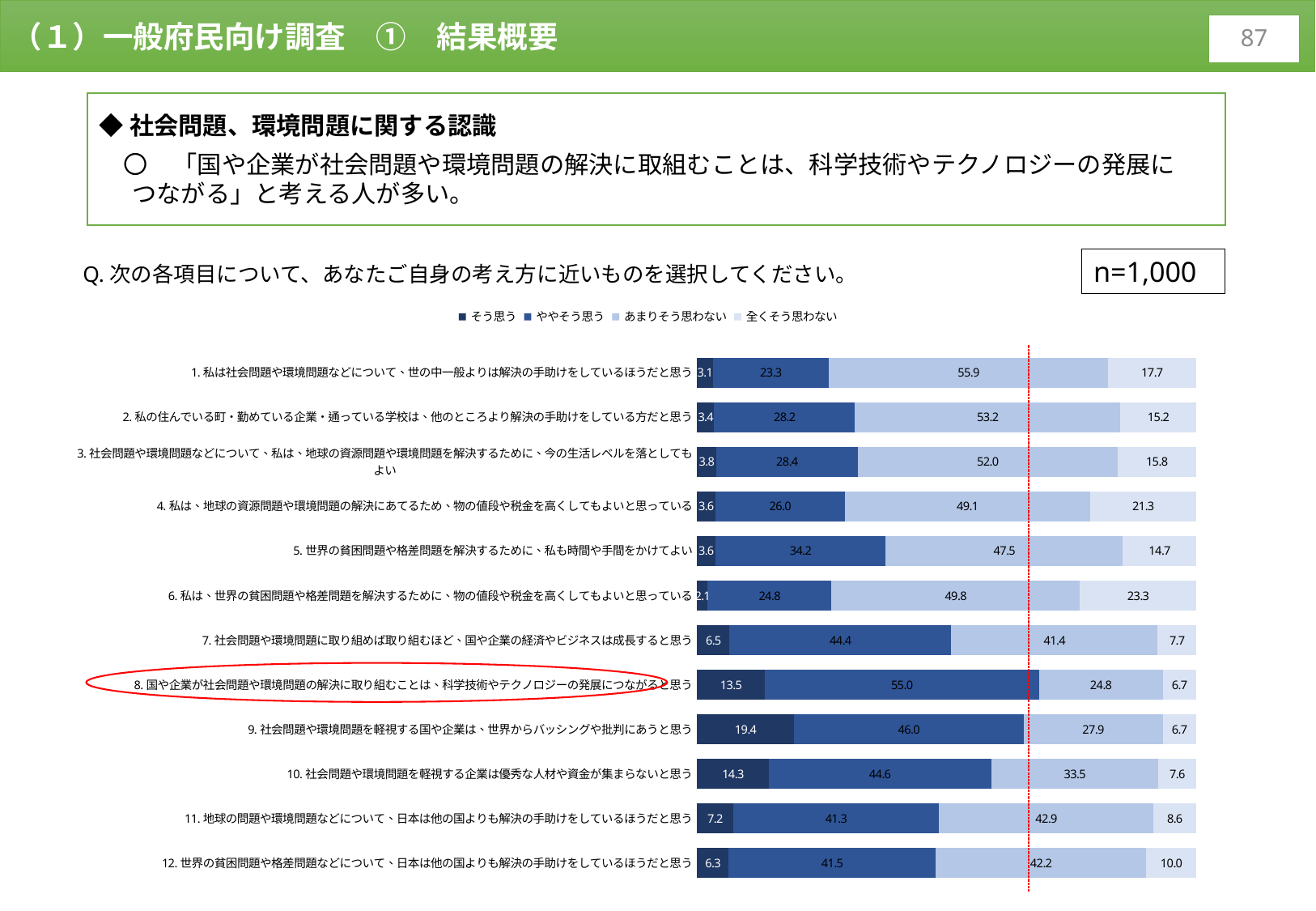
What is the 「ややそう思う」 value for statement 8 (国や企業が社会問題や環境問題の解決に取り組むことは、科学技術やテクノロジーの発展につながると思う)? 55.0 What is the combined 「そう思う」 and 「ややそう思う」 value for statement 8? 68.5 What is the 「そう思う」 value for statement 9 (社会問題や環境問題を軽視する国や企業は、世界からバッシングや批判にあうと思う)? 19.4 Which statement has the highest 「そう思う」 value? 9. 社会問題や環境問題を軽視する国や企業は、世界からバッシングや批判にあうと思う What kind of chart is shown on the slide? Stacked bar chart Which statement has the highest 「全くそう思わない」 value? 6. 私は、世界の貧困問題や格差問題を解決するために、物の値段や税金を高くしてもよいと思っている What is the difference between the 「ややそう思う」 values of statement 8 and statement 9? 9.0 What is the 「あまりそう思わない」 value for statement 1? 55.9 Which statement has the lowest 「そう思う」 value? 6. 私は、世界の貧困問題や格差問題を解決するために、物の値段や税金を高くしてもよいと思っている How many statements (categories) are plotted in the chart? 12 Which has the larger 「ややそう思う」 value, statement 4 or statement 5? Statement 5 How many series does the chart legend list? 4